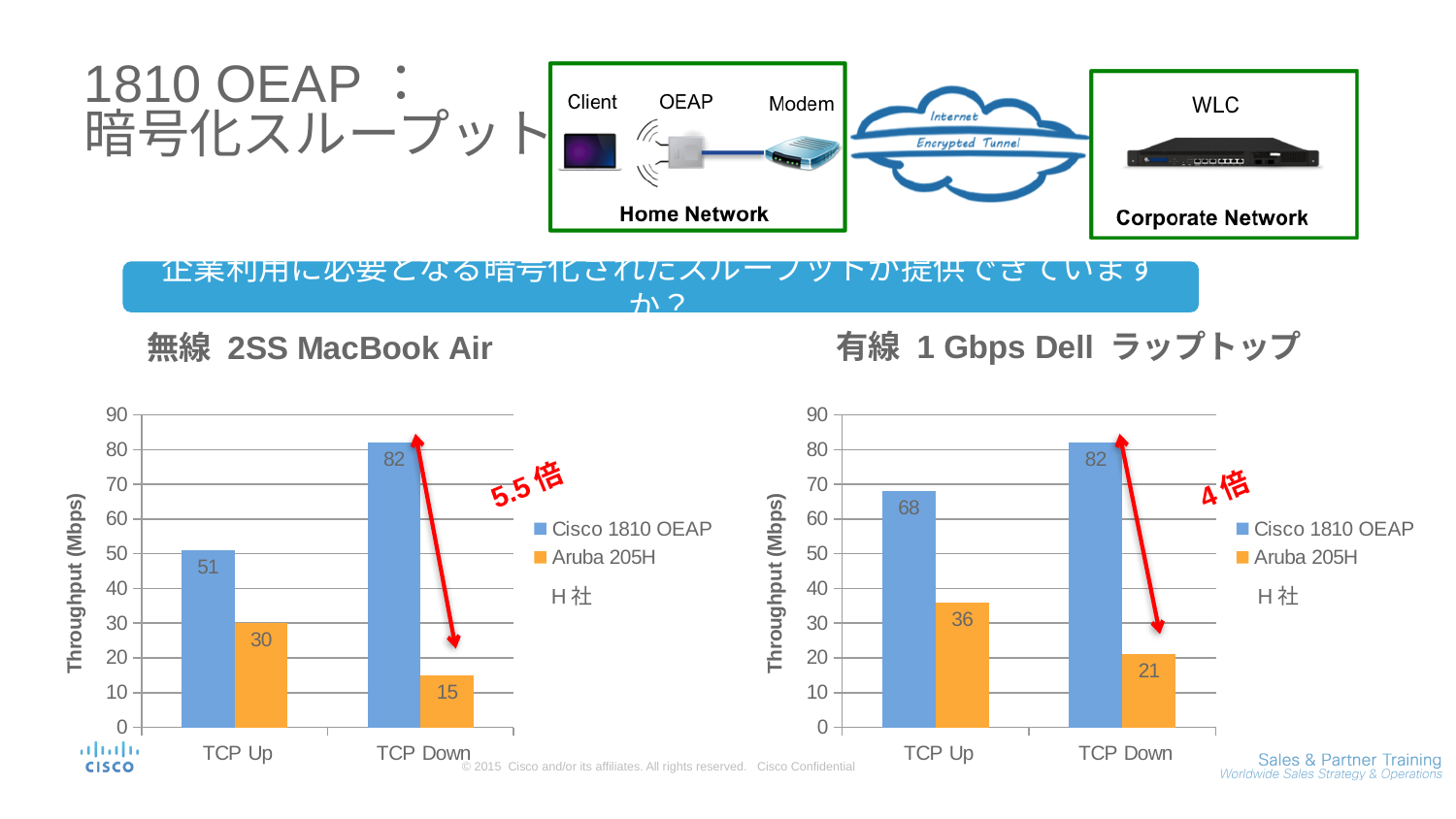
How many categories are shown on the x axis of the right chart? 2 In the left chart (無線 2SS MacBook Air), what is the TCP Down throughput for Cisco 1810 OEAP? 82 In the left chart, which series has the lowest value overall? Aruba 205H (TCP Down, 15) In the left chart, what is the difference between the Cisco 1810 OEAP and Aruba 205H TCP Down values? 67 In the right chart (有線 1 Gbps Dell ラップトップ), what is the TCP Up throughput for Cisco 1810 OEAP? 68 How many series does the legend of the left chart list? 2 In the right chart, what is the difference between the Cisco 1810 OEAP and Aruba 205H TCP Up values? 32 What type of chart is the left chart? Bar chart In the right chart (有線 1 Gbps Dell ラップトップ), what is the TCP Down throughput for Aruba 205H? 21 What is the y-axis label of the right chart? Throughput (Mbps) In the right chart, which is larger: Aruba 205H TCP Up or Aruba 205H TCP Down? TCP Up In the left chart (無線 2SS MacBook Air), what is the TCP Up throughput for Aruba 205H? 30